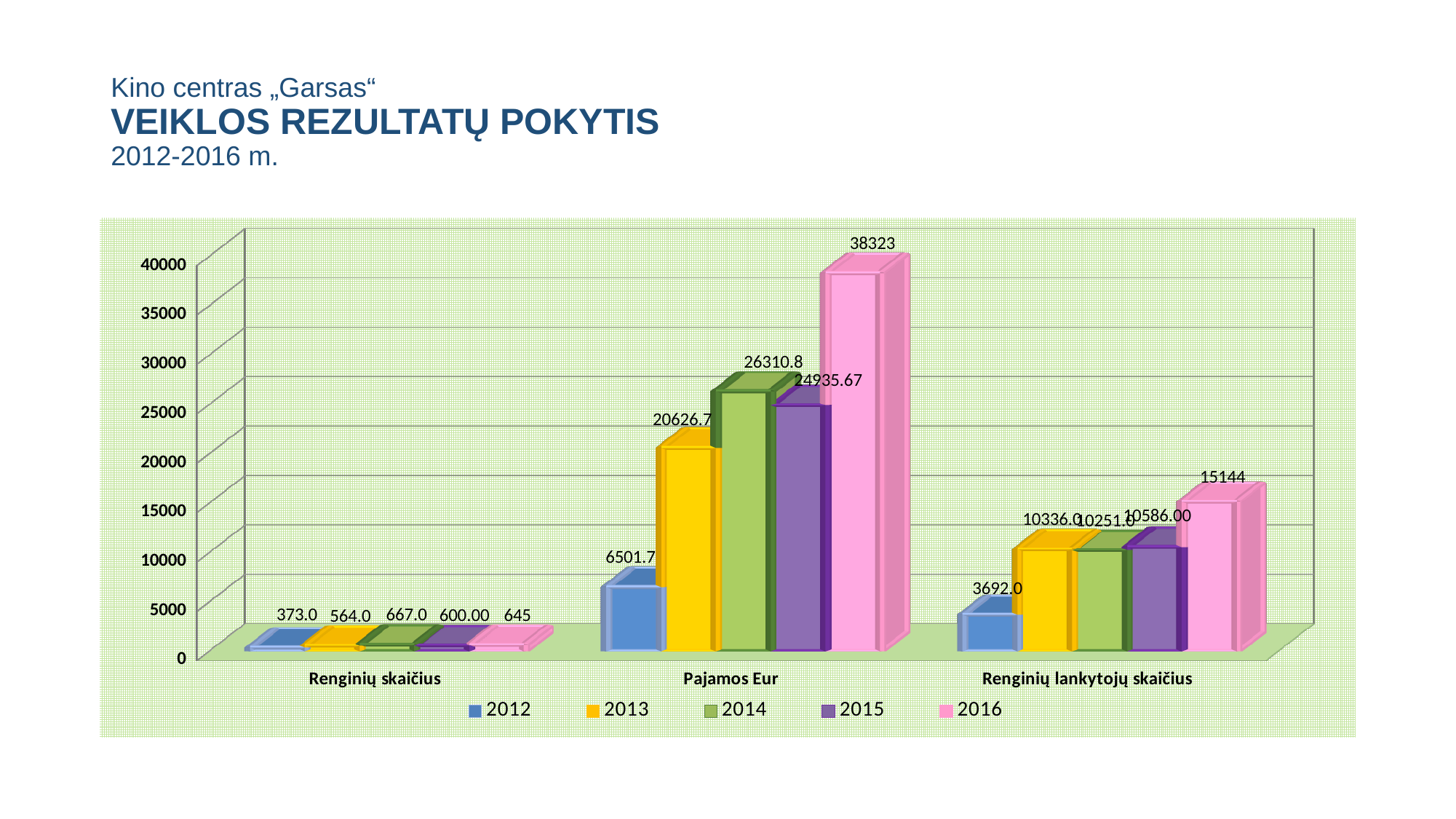
What is the difference between the 2016 and 2012 values in the Pajamos Eur category? 31821.3 What is the value for 2016 in the Pajamos Eur category? 38323 What is the value for 2016 in the Renginių lankytojų skaičius category? 15144 What is the value for 2012 in the Renginių skaičius category? 373.0 Which year has the lowest value in the Renginių lankytojų skaičius category? 2012 Is the value for 2016 in the Pajamos Eur category greater or less than 35000? greater What kind of chart is shown on the slide? bar chart Which is larger in the Pajamos Eur category: the value for 2013 or the value for 2014? 2014 What is the value for 2015 in the Pajamos Eur category? 24935.67 Which year has the highest value in the Pajamos Eur category? 2016 How many categories are shown on the x axis? 3 How many series does the legend list? 5